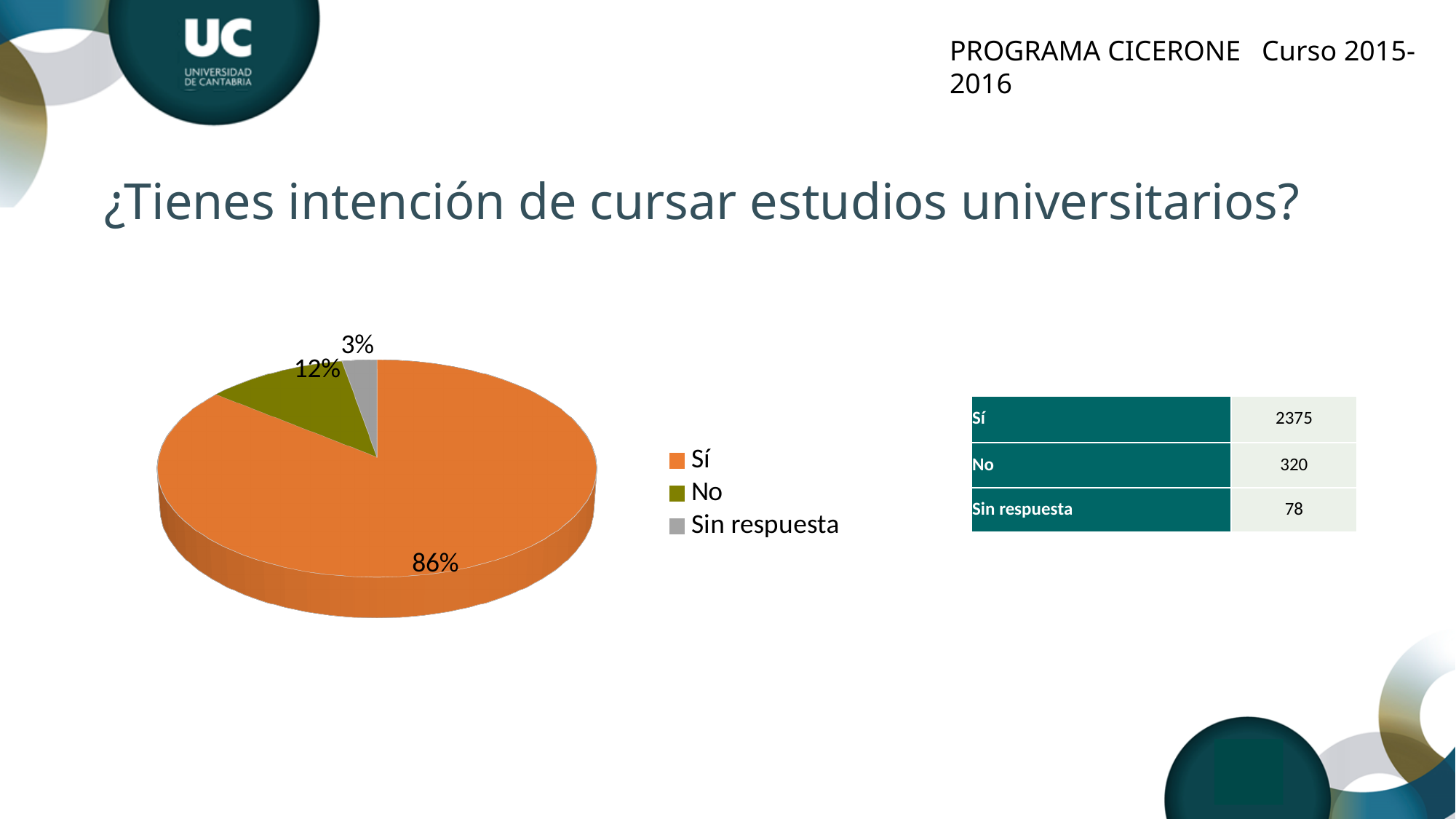
What percentage of the pie chart is labelled for "Sí"? 86% How many categories does the pie chart show? 3 What percentage of the pie chart is labelled for "Sin respuesta"? 3% What is the difference in percentage points between the "Sí" slice and the "No" slice? 74 What colour is the "Sin respuesta" slice in the pie chart? grey Which slice is larger in the pie chart, "No" or "Sin respuesta"? No Which category has the smallest slice of the pie chart? Sin respuesta What percentage of the pie chart is labelled for "No"? 12% How many entries does the legend of the pie chart list? 3 What kind of chart is shown on the slide? pie chart What colour is the "Sí" slice in the pie chart? orange Which category has the largest slice of the pie chart? Sí